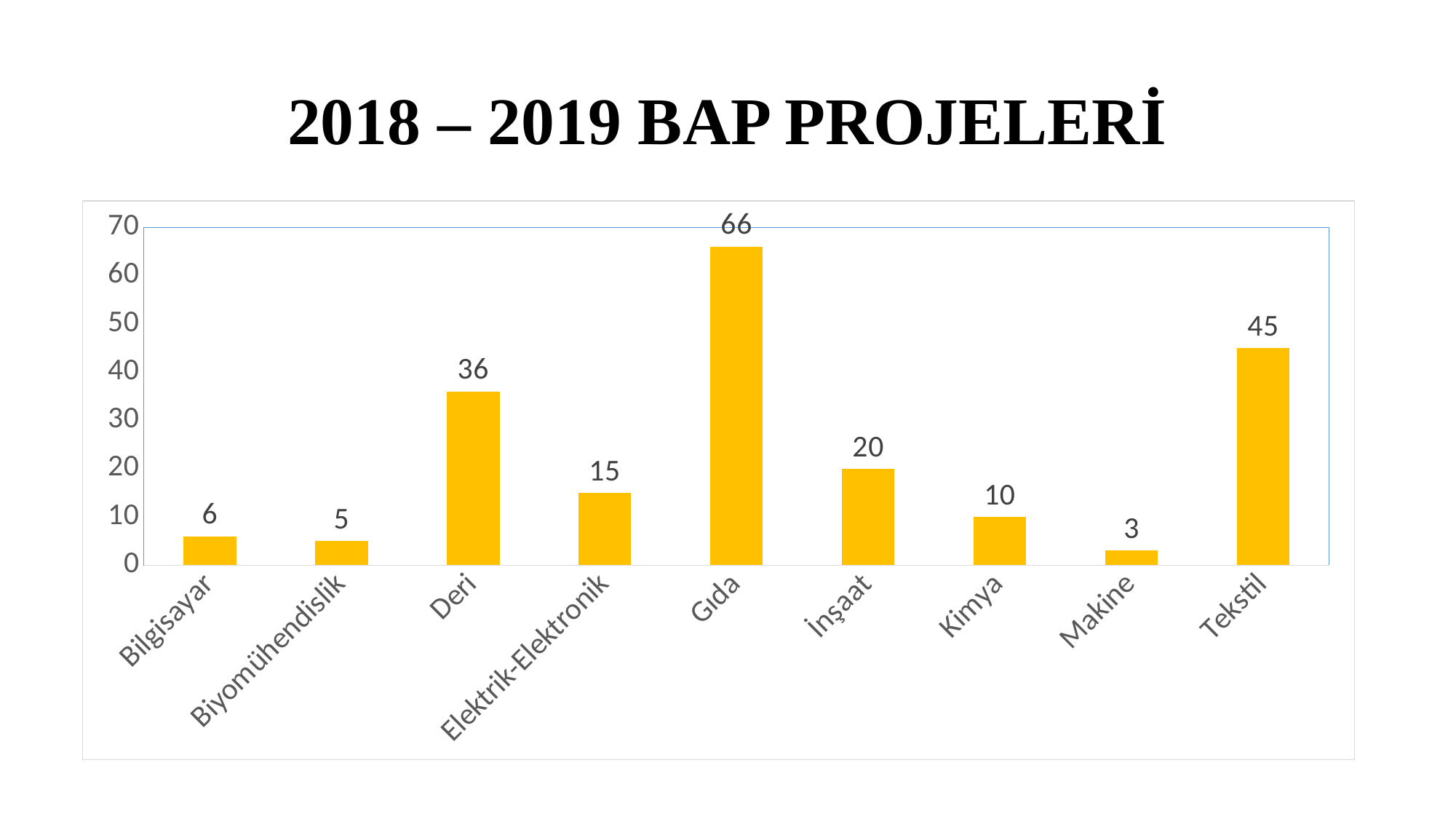
What is the difference between the values for Gıda and Tekstil? 21 What is the value for Deri? 36 Which category has the lowest value? Makine What kind of chart is shown on the slide? bar chart Is the value for Elektrik-Elektronik greater or less than 20? less Which category has the highest value? Gıda What is the title of the slide? 2018 – 2019 BAP PROJELERİ Which is larger, the value for Deri or the value for Tekstil? Tekstil What is the value for Gıda? 66 What is the value for Makine? 3 What is the difference between the values for İnşaat and Kimya? 10 How many categories are shown on the x axis? 9